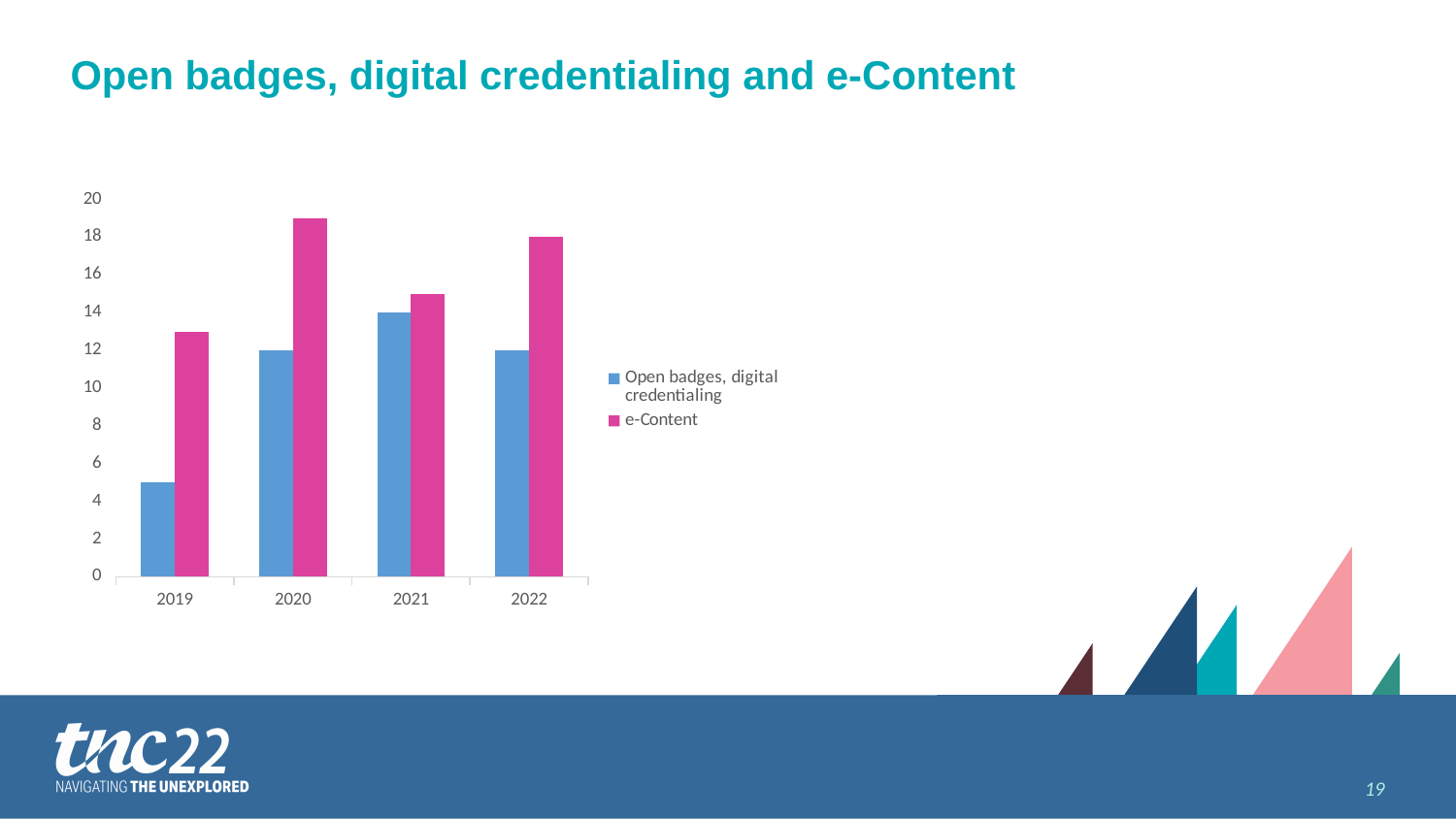
Is the Open badges, digital credentialing value for 2019 greater or less than 8? less In which year is the Open badges, digital credentialing value lowest? 2019 How many years are shown on the x axis? 4 In which year is the Open badges, digital credentialing value highest? 2021 Is the e-Content value for 2020 greater or less than 16? greater In which year is the e-Content value highest? 2020 What kind of chart is shown on the slide? bar chart How many series does the legend list? 2 In which year is the e-Content value lowest? 2019 Is the e-Content value for 2022 greater or less than 14? greater In 2019, which series has the larger value, Open badges, digital credentialing or e-Content? e-Content Which colour represents e-Content in the chart? pink